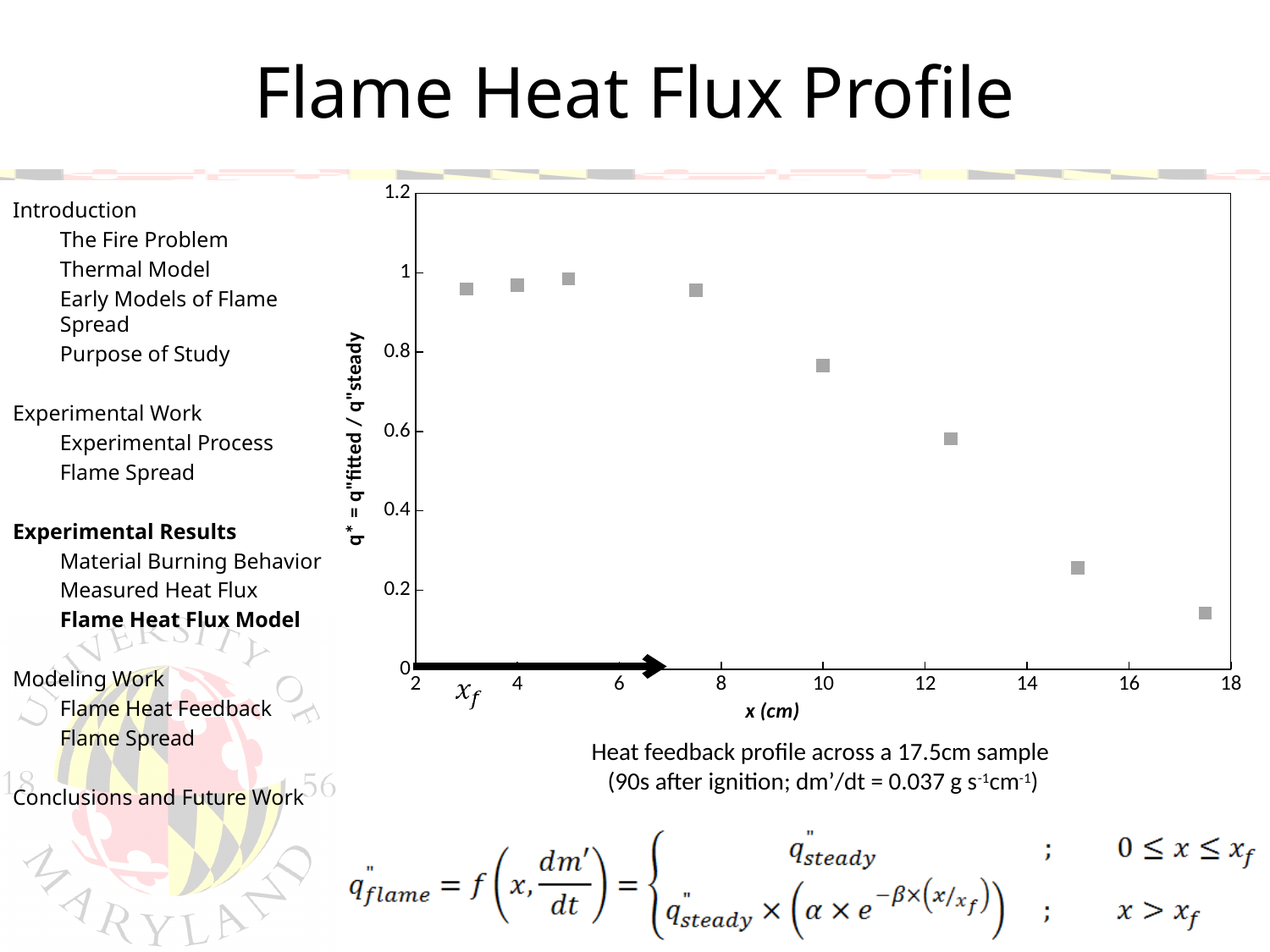
Is the value at x = 12.5 cm greater or less than 0.4? greater At which x value (cm) is the plotted value lowest? 17.5 Do the plotted values rise or fall as x increases from 10 cm to 18 cm? fall Which has the larger plotted value, x = 10 cm or x = 15 cm? x = 10 cm Is the value at x = 15 cm greater or less than 0.4? less What kind of chart is shown on the slide? scatter plot What is the label of the x axis? x (cm) Is the value at x = 5 cm greater or less than 0.8? greater How many data points are plotted on the chart? 8 What is the maximum value shown on the y axis? 1.2